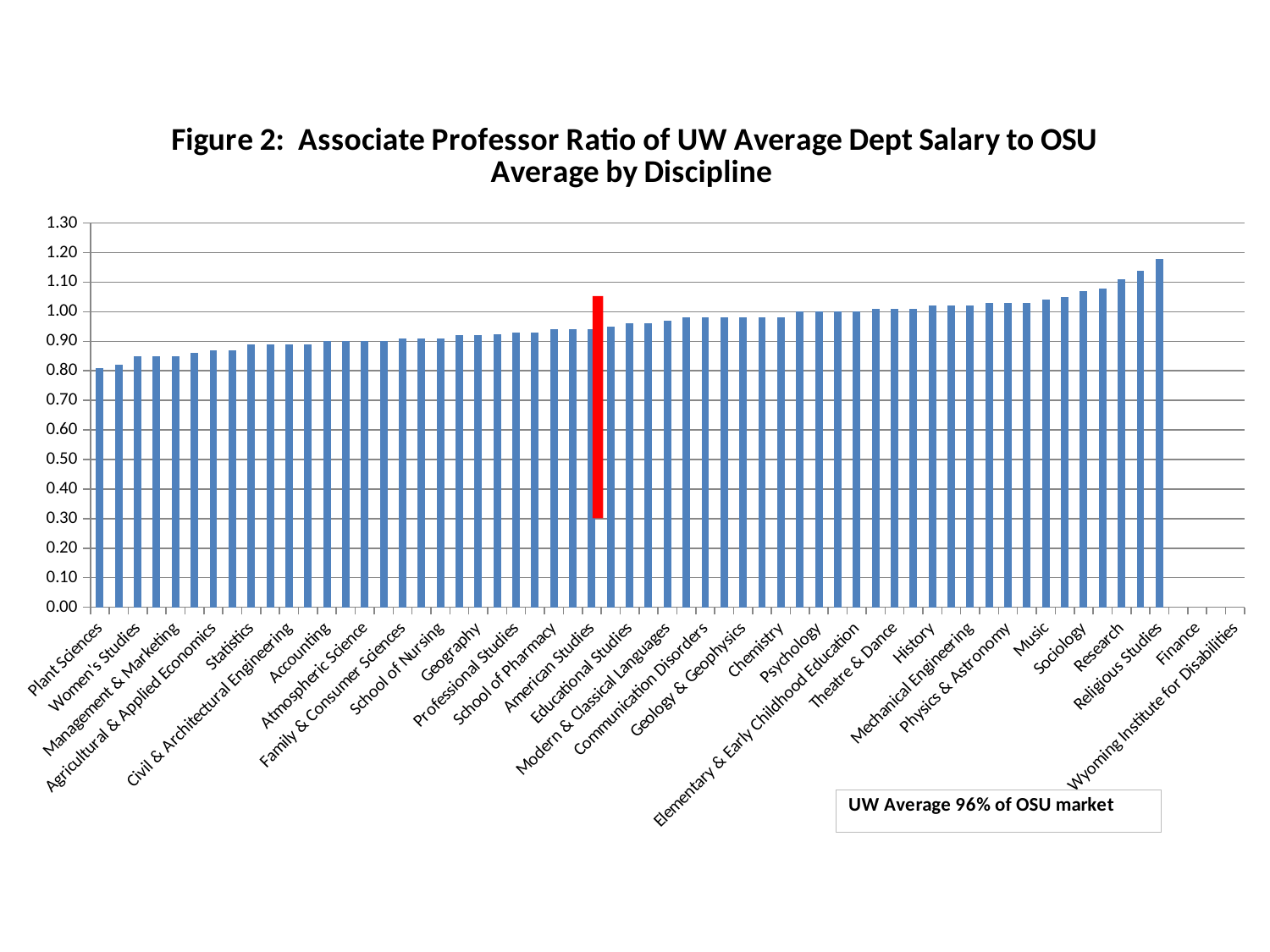
Which discipline has the highest ratio? Religious Studies According to the text box on the slide, UW average salary is what percentage of the OSU market? 96% What kind of chart is shown on the slide? bar chart What is the title of the chart? Figure 2: Associate Professor Ratio of UW Average Dept Salary to OSU Average by Discipline Is the value for Plant Sciences greater or less than 0.90? less Is the value for Accounting greater or less than 1.00? less Which has the larger ratio, Plant Sciences or Religious Studies? Religious Studies Which has the larger ratio, Accounting or Sociology? Sociology Is the value for Sociology greater or less than 1.00? greater Do the bar values generally rise or fall from left to right along the x axis? rise